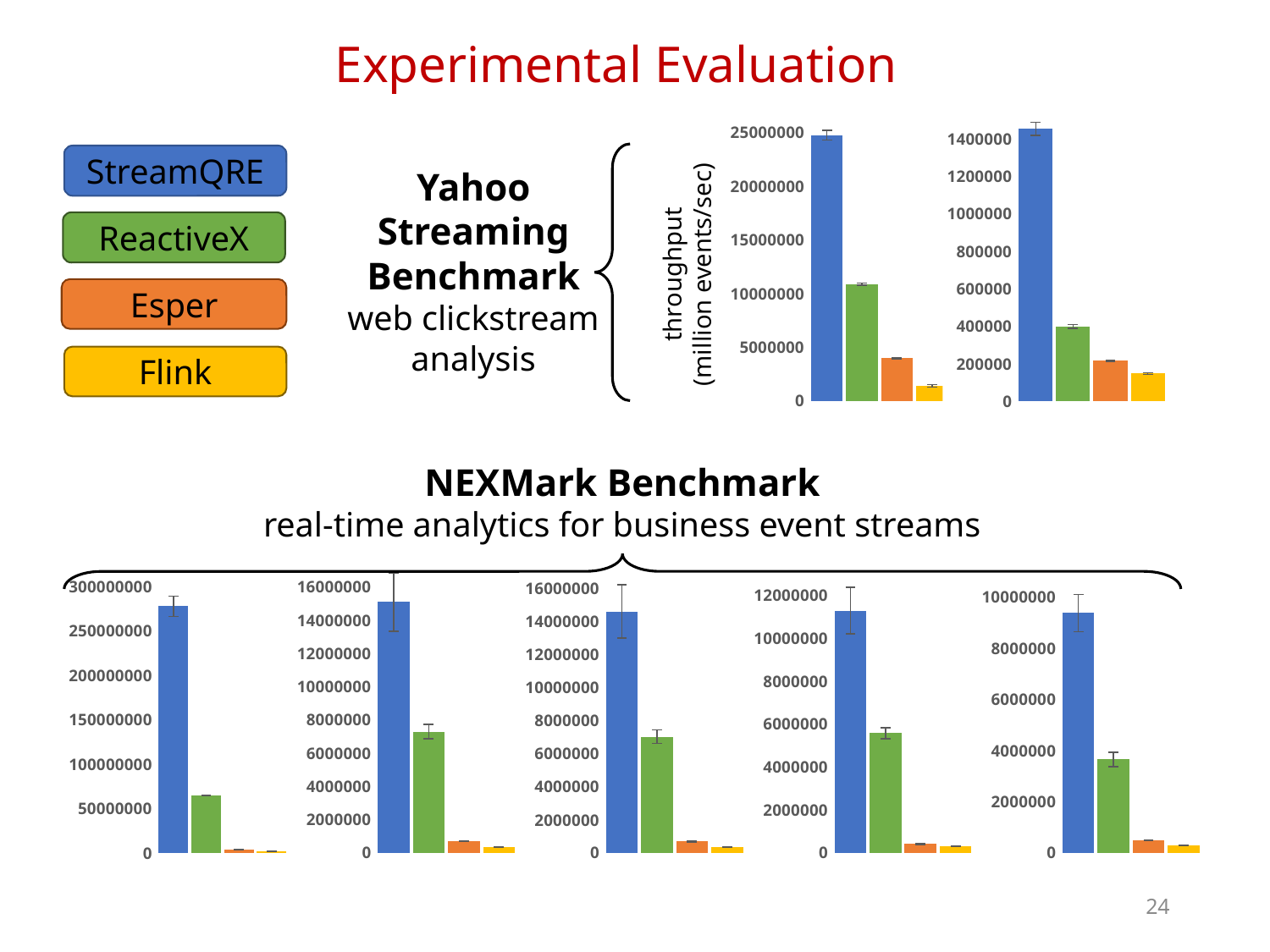
In the leftmost Yahoo Streaming Benchmark chart, which system has the highest throughput? StreamQRE In the rightmost NEXMark Benchmark chart, is the value for StreamQRE greater or less than 8000000? greater In the leftmost Yahoo Streaming Benchmark chart, is the value for StreamQRE greater or less than 20000000? greater How many charts are shown in the NEXMark Benchmark section? 5 In the right-hand Yahoo Streaming Benchmark chart, is the value for StreamQRE greater or less than 1200000? greater How many bars does the leftmost chart in the Yahoo Streaming Benchmark section have? 4 What kind of chart is the leftmost chart in the Yahoo Streaming Benchmark section? bar chart Which colour represents Esper in the legend on the slide? orange In the leftmost Yahoo Streaming Benchmark chart, which system has the lowest throughput? Flink